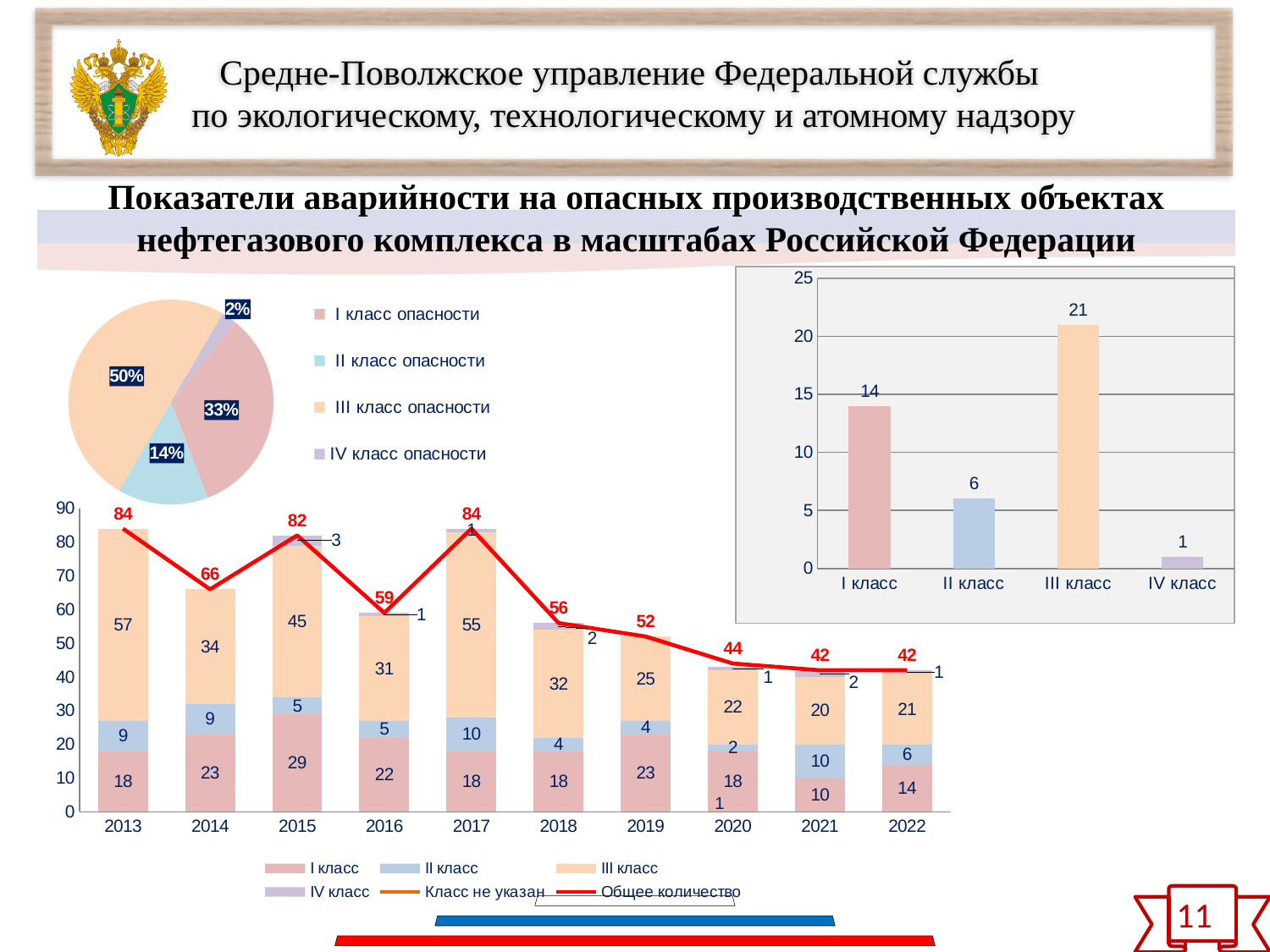
In the bar chart at the top right, what is the value for III класс? 21 In the bar chart at the top right, which class has the highest value? III класс In the bar chart at the top right, how many categories are shown on the x axis? 4 In the pie chart at the top left, what share does III класс опасности have? 50% In the stacked bar chart at the bottom, what is the value of III класс in 2013? 57 In the stacked bar chart at the bottom, how many entries does the legend list? 6 In the bar chart at the top right, what is the difference between I класс and II класс? 8 In the stacked bar chart at the bottom, is the value of I класс larger in 2015 or in 2022? 2015 In the pie chart at the top left, which class has the smallest share? IV класс опасности In the stacked bar chart at the bottom, does the Общее количество line generally rise or fall from 2017 to 2022? fall In the stacked bar chart at the bottom, what is the total (Общее количество) for 2016? 59 In the stacked bar chart at the bottom, which year has the lowest value for I класс? 2021